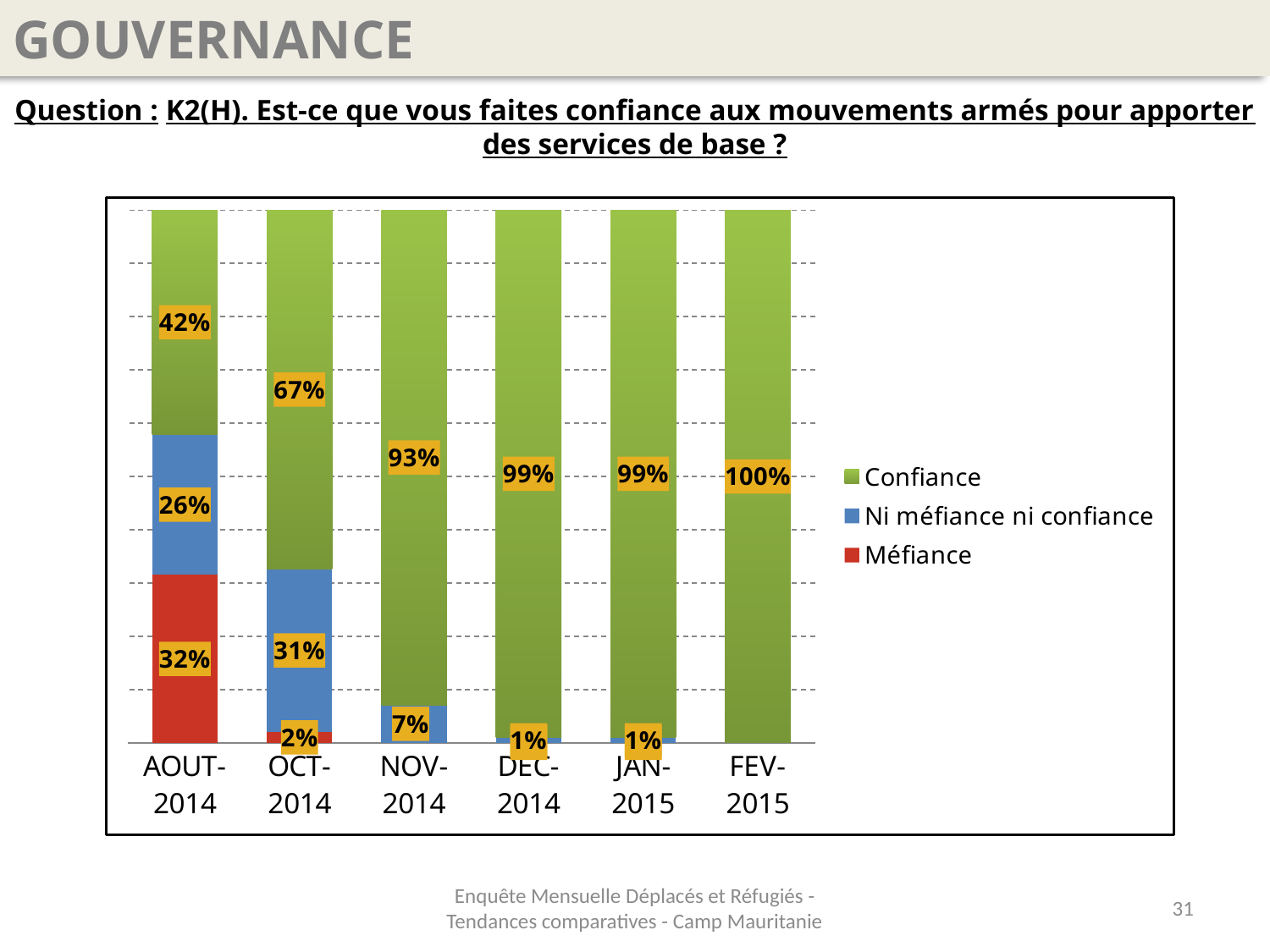
Which month has the lowest Confiance value? AOUT-2014 Does the Confiance value rise or fall from AOUT-2014 to FEV-2015? rise What is the Confiance value for NOV-2014? 93% What is the Confiance value for AOUT-2014? 42% What is the Ni méfiance ni confiance value for OCT-2014? 31% How many series does the legend list? 3 Which is larger for AOUT-2014: the Méfiance value or the Ni méfiance ni confiance value? Méfiance What is the Confiance value for FEV-2015? 100% What is the difference between the Confiance values for OCT-2014 and AOUT-2014? 25% Which month has the highest Confiance value? FEV-2015 How many months are shown on the x axis? 6 What is the Méfiance value for AOUT-2014? 32%